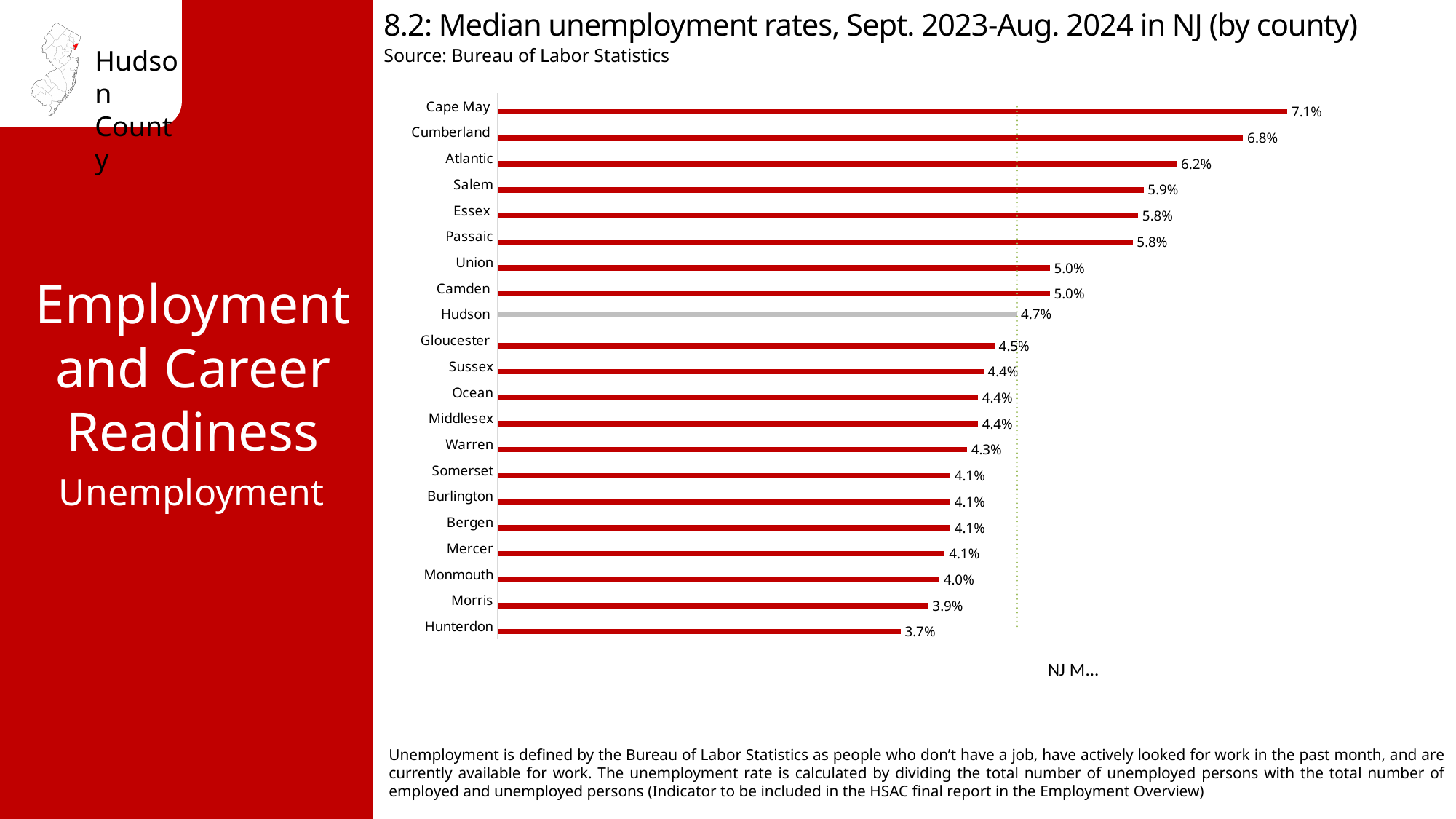
Which has a higher median unemployment rate, Salem or Union? Salem Which county has the lowest median unemployment rate? Hunterdon What is the median unemployment rate for Hunterdon? 3.7% Which county's bar is coloured grey instead of red? Hudson How many counties are shown in the chart? 21 What is the median unemployment rate for Cape May? 7.1% What is the difference between the median unemployment rates of Cape May and Hunterdon? 3.4% What is the median unemployment rate for Atlantic? 6.2% What kind of chart is shown on the slide? Bar chart Which county has the highest median unemployment rate? Cape May What is the difference between the median unemployment rates of Cumberland and Hudson? 2.1% What is the median unemployment rate for Hudson County? 4.7%